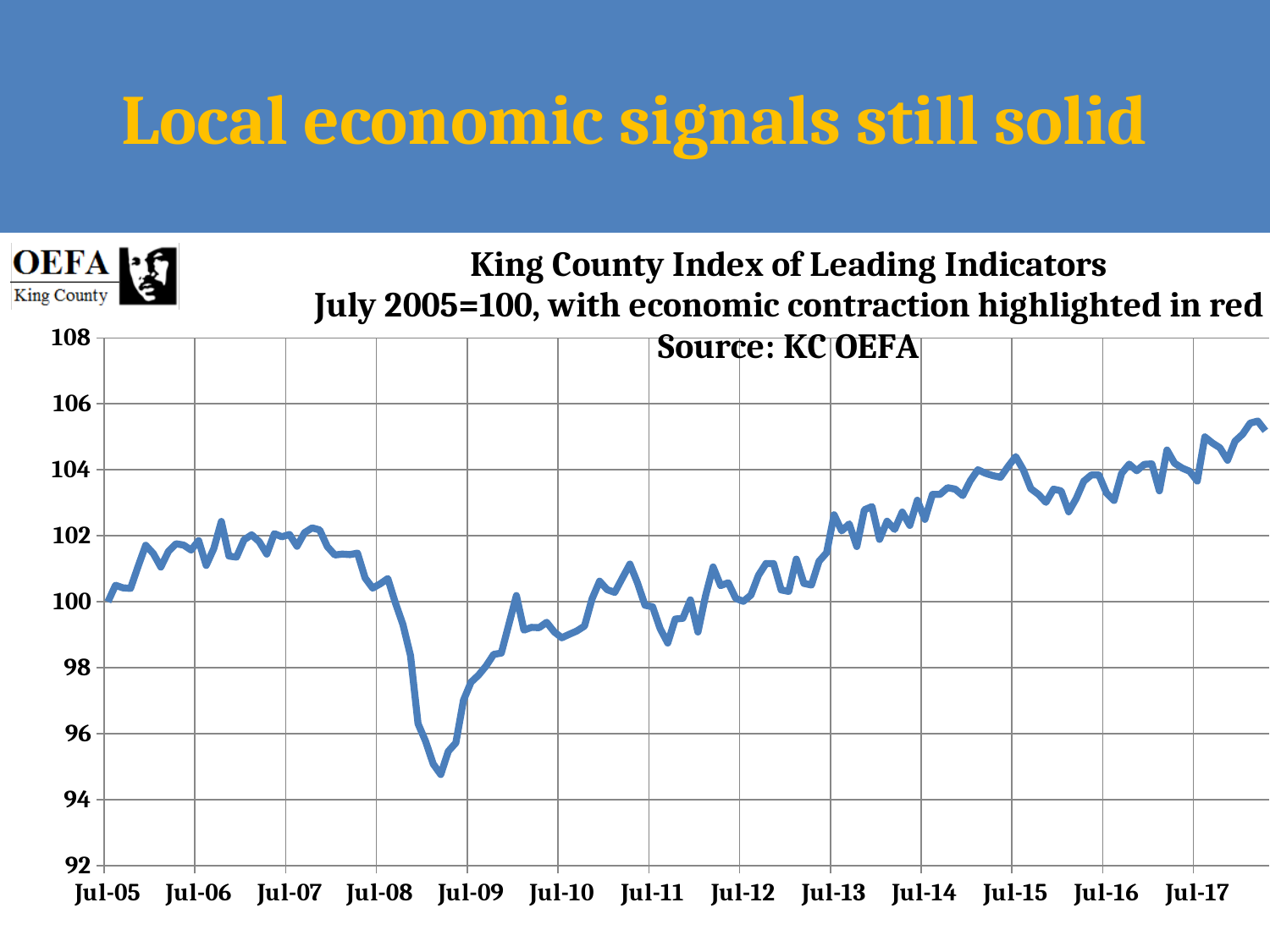
What is the index value in July 2005, the base period? 100 Is the lowest point of the index, reached between Jul-08 and Jul-09, greater or less than 96? less What kind of chart is shown on the slide? line chart What is the title of the chart? King County Index of Leading Indicators Is the index value at Jul-06 greater or less than 100? greater Which is larger, the index value at Jul-17 or at Jul-09? Jul-17 Is the index value at Jul-13 greater or less than 100? greater What is the source of the chart's data, as stated on the slide? KC OEFA Overall, does the index rise or fall from Jul-05 to the end of the series? rise How many labels are shown on the x axis? 13 Between which two x-axis labels does the index reach its lowest point? Jul-08 and Jul-09